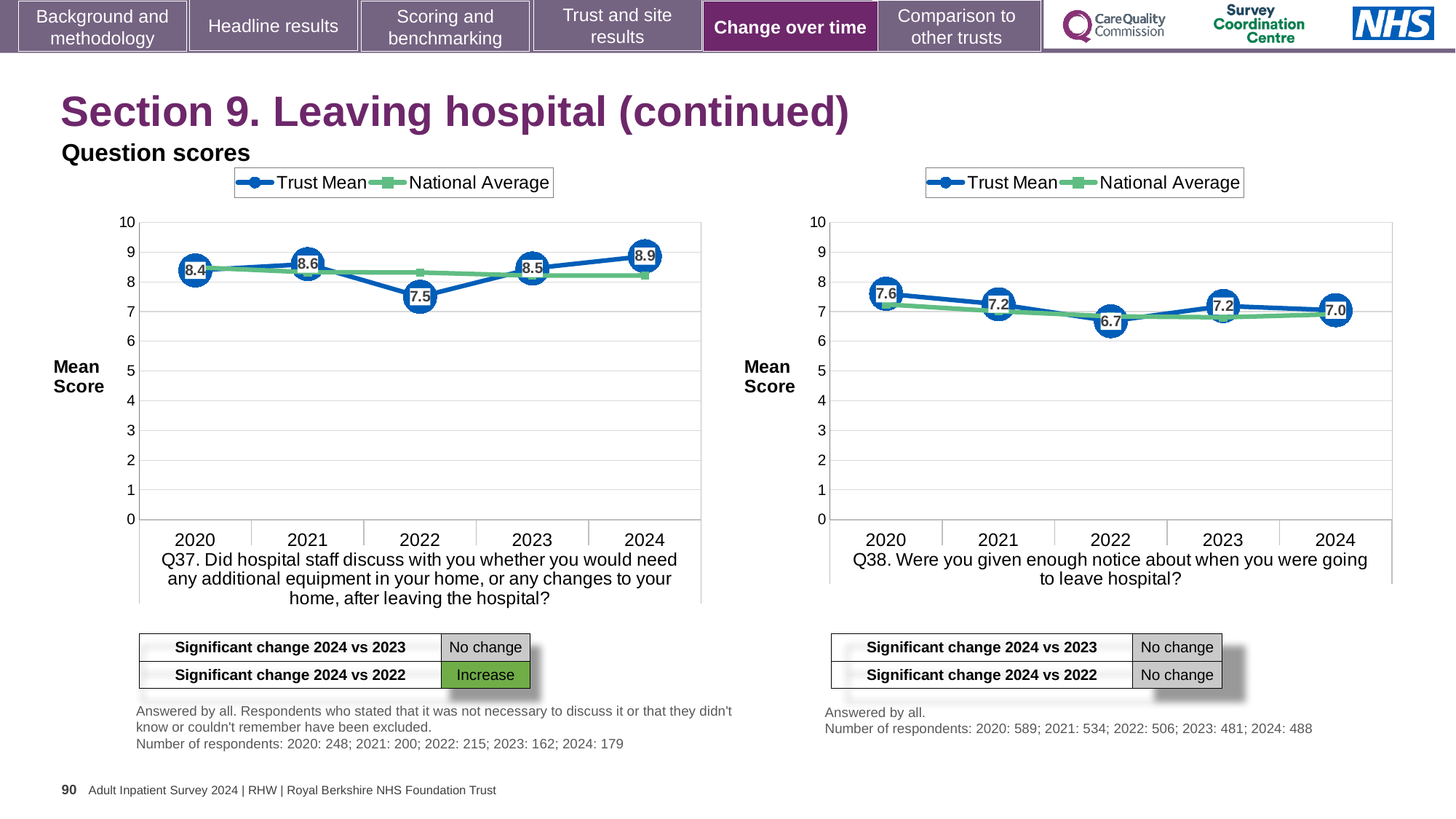
In the Q37 chart (left), what is the Trust Mean score for 2022? 7.5 In the Q37 chart (left), which year has the lowest Trust Mean score? 2022 In the Q37 chart (left), which year has the highest Trust Mean score? 2024 In the Q37 chart (left), what is the Trust Mean score for 2024? 8.9 How many series does the legend of the Q37 chart (left) list? 2 In the Q38 chart (right), what is the Trust Mean score for 2020? 7.6 In the Q38 chart (right), is the National Average for 2020 greater or less than 8? less What type of chart is the Q38 chart (right)? Line chart In the Q37 chart (left), what is the difference between the Trust Mean scores for 2024 and 2022? 1.4 In the Q38 chart (right), which year has the lowest Trust Mean score? 2022 In the Q38 chart (right), what is the difference between the Trust Mean scores for 2020 and 2022? 0.9 In the Q38 chart (right), is the Trust Mean score for 2020 greater or less than the score for 2024? greater